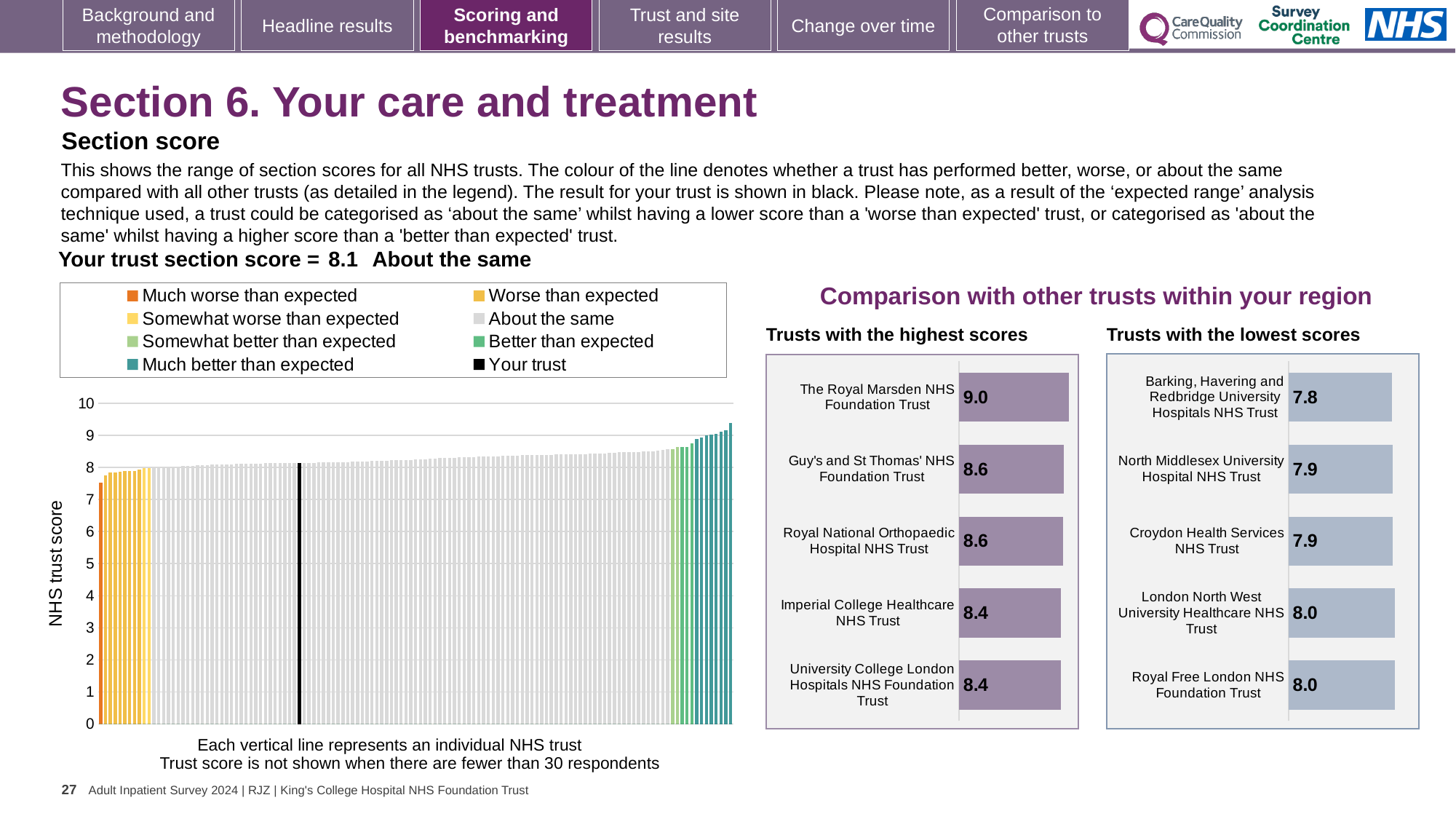
In the 'Trusts with the highest scores' chart, which trust has the highest score? The Royal Marsden NHS Foundation Trust In the main 'NHS trust score' chart, do the values rise or fall from left to right? rise How many entries does the legend of the main 'NHS trust score' chart list? 8 In the 'Trusts with the lowest scores' chart, what is the score for Barking, Havering and Redbridge University Hospitals NHS Trust? 7.8 In the 'Trusts with the highest scores' chart, which has the higher score: Guy's and St Thomas' NHS Foundation Trust or Imperial College Healthcare NHS Trust? Guy's and St Thomas' NHS Foundation Trust In the 'Trusts with the highest scores' chart, what is the score for The Royal Marsden NHS Foundation Trust? 9.0 What kind of chart is the main 'NHS trust score' chart on the left of the slide? bar chart How many trusts are shown in the 'Trusts with the highest scores' chart? 5 In the 'Trusts with the lowest scores' chart, what is the score for Croydon Health Services NHS Trust? 7.9 In the 'Trusts with the highest scores' chart, what is the difference between the scores of The Royal Marsden NHS Foundation Trust and Imperial College Healthcare NHS Trust? 0.6 In the 'Trusts with the lowest scores' chart, what is the difference between the scores of Royal Free London NHS Foundation Trust and Barking, Havering and Redbridge University Hospitals NHS Trust? 0.2 In the 'Trusts with the lowest scores' chart, which trust has the lowest score? Barking, Havering and Redbridge University Hospitals NHS Trust